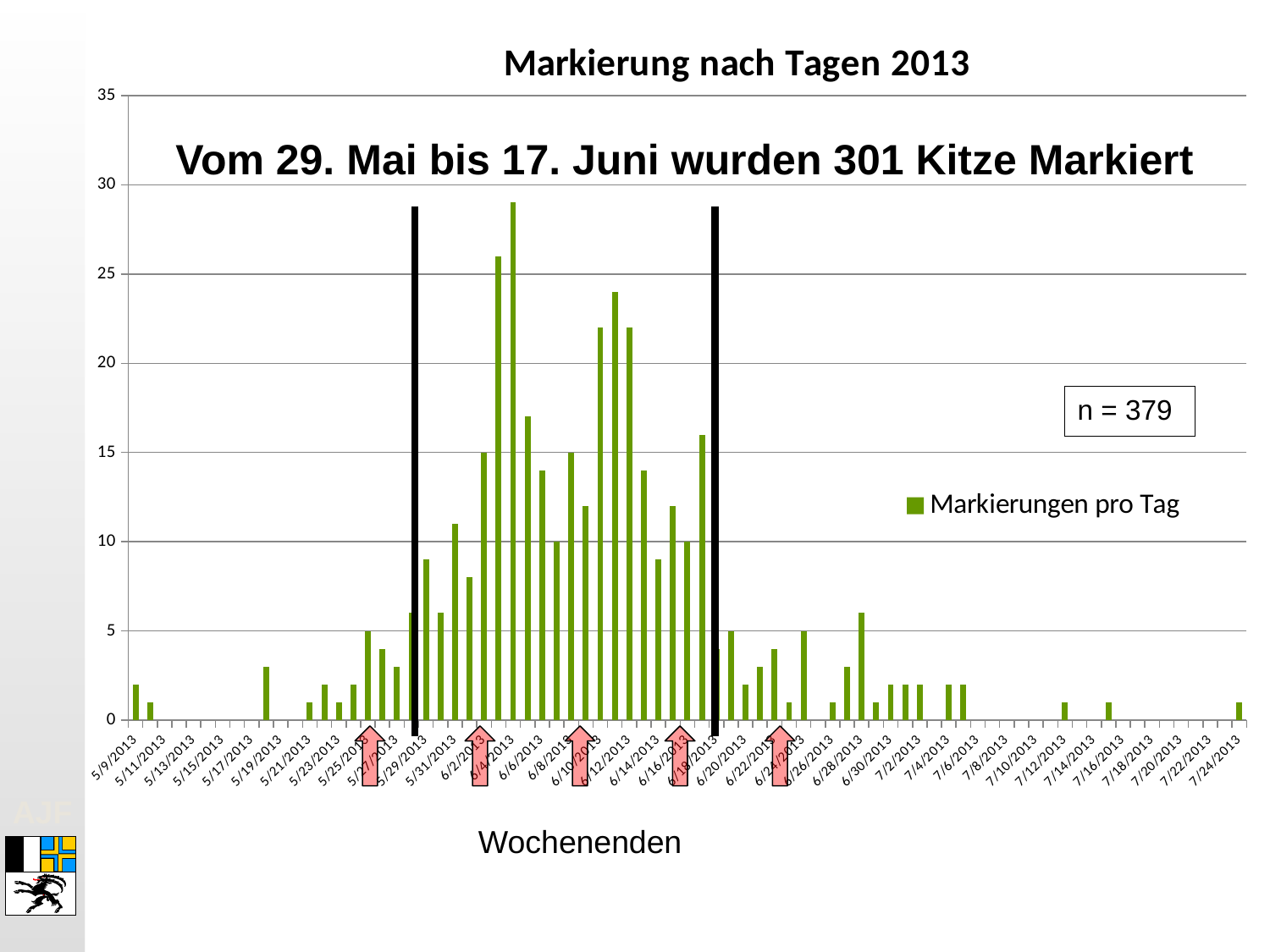
What is the title of the chart? Markierung nach Tagen 2013 Is the value for 6/4/2013 greater or less than 20? greater What kind of chart is shown on the slide? bar chart Is the value for 7/24/2013 greater or less than 5? less Is the value for 5/19/2013 greater or less than 5? less How many series does the legend list? 1 What is the legend entry for the green bars? Markierungen pro Tag Which has the larger value, 6/12/2013 or 6/2/2013? 6/12/2013